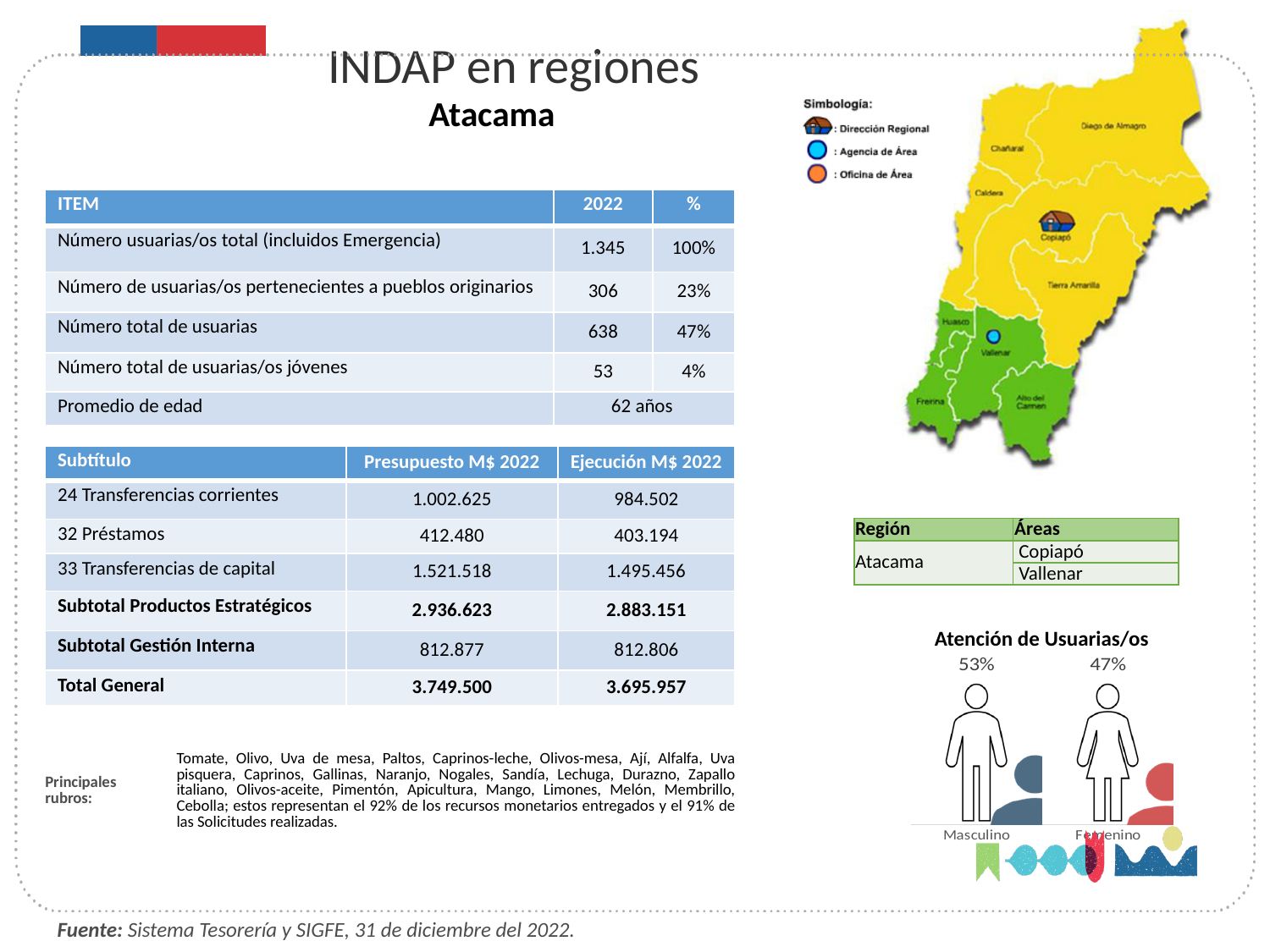
In the 'Atención de Usuarias/os' chart, what share does Femenino represent? 47% What is the title of the chart in the lower right of the slide? Atención de Usuarias/os In the 'Atención de Usuarias/os' chart, which category has the lowest value? Femenino In the 'Atención de Usuarias/os' chart, what is the total of the Masculino and Femenino values? 100% How many categories are shown in the 'Atención de Usuarias/os' chart? 2 In the 'Atención de Usuarias/os' chart, which category has the highest value? Masculino In the 'Atención de Usuarias/os' chart, what colour is used for the Femenino figure? Red In the 'Atención de Usuarias/os' chart, what is the difference between the Masculino and Femenino values? 6% In the 'Atención de Usuarias/os' chart, which is larger, Masculino or Femenino? Masculino In the 'Atención de Usuarias/os' chart, what is the value for Masculino? 53% In the 'Atención de Usuarias/os' chart, what is the value for Femenino? 47%